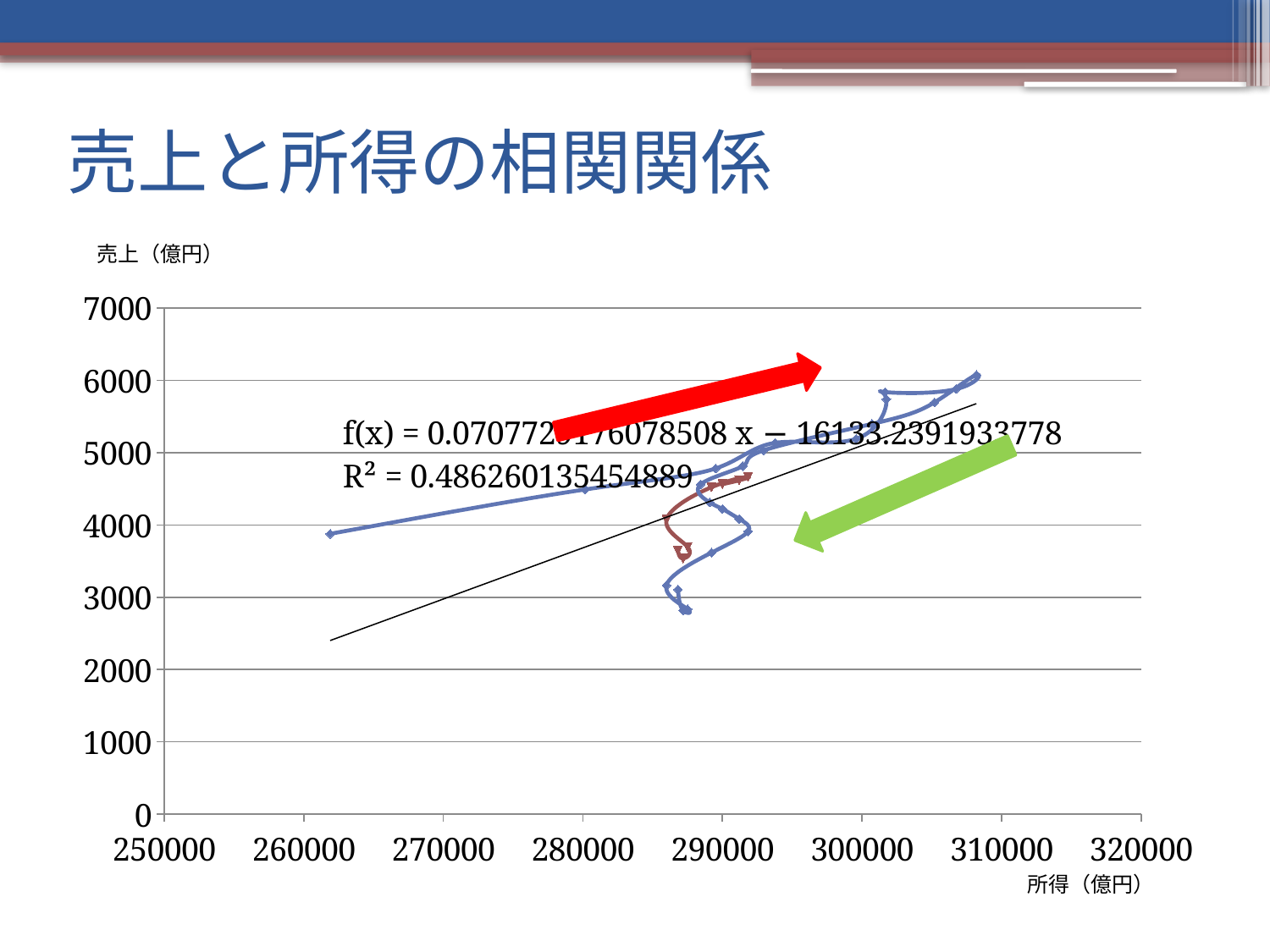
Is the income (所得) of the rightmost plotted point greater or less than 300000? greater What R² value is printed on the chart? 0.486260135454889 What is the label on the x axis of the chart? 所得（億円） What kind of chart is shown on the slide? scatter chart Is the sales (売上) value of the leftmost plotted point greater or less than 5000? less Is the income (所得) of the leftmost plotted point greater or less than 270000? less Which has the higher sales (売上) value: the leftmost plotted point or the rightmost plotted point? the rightmost point Does the trendline rise or fall as income (所得) increases along the x axis? rises What is the title of the slide's chart? 売上と所得の相関関係 What is the constant term (intercept) in the trendline equation printed on the chart? −16133.2391933778